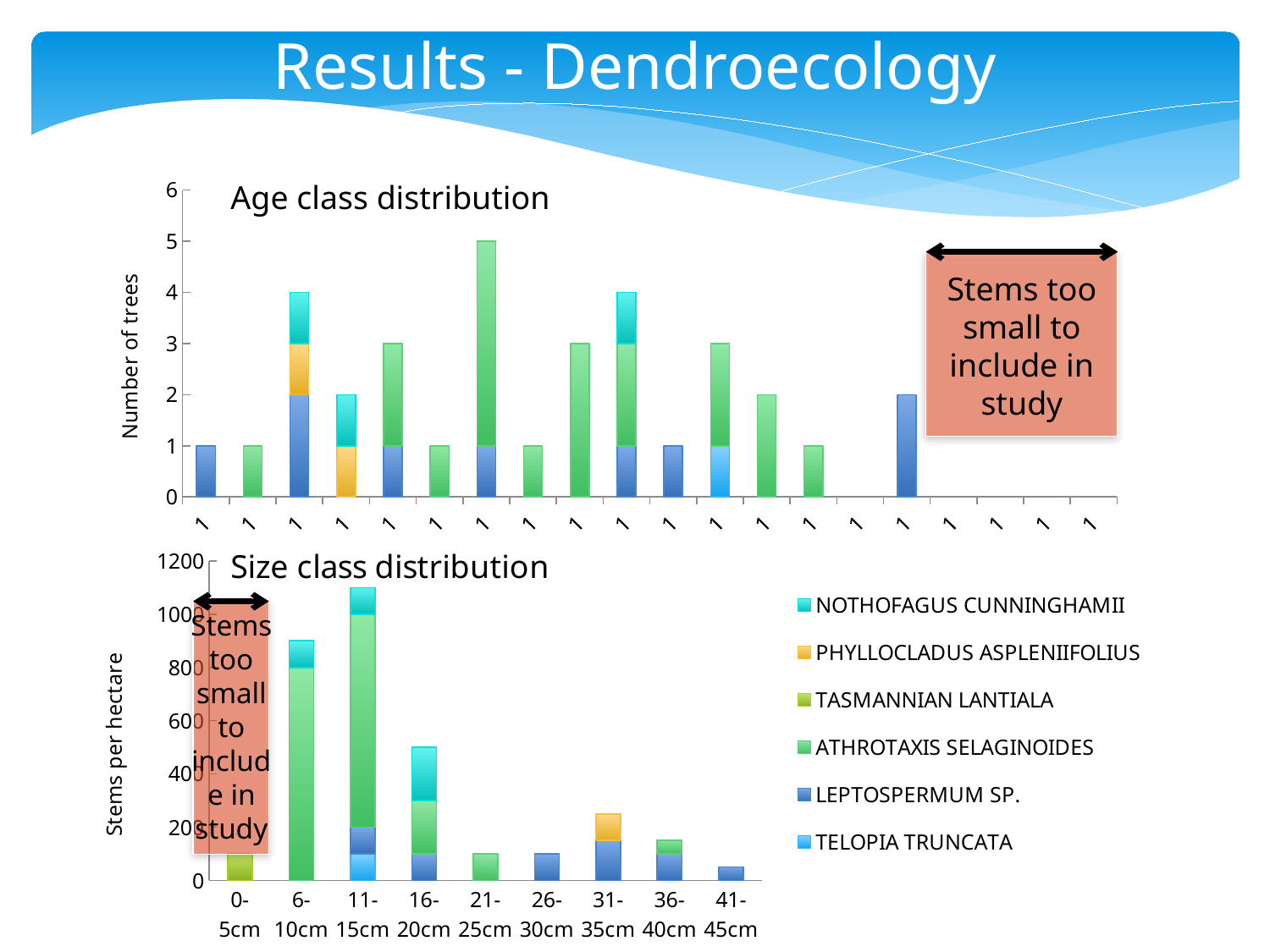
In the Size class distribution chart, is the total for 16-20cm greater or less than 600? less In the Age class distribution chart, what is the highest number of trees reached by any bar? 5 How many size classes are shown on the x axis of the Size class distribution chart? 9 How many series does the legend list? 6 In the Size class distribution chart, is the total for 6-10cm greater or less than 800? greater In the Size class distribution chart, which has the larger total, 6-10cm or 16-20cm? 6-10cm In the Size class distribution chart, is the total for 11-15cm greater or less than 1000? greater In the Size class distribution chart, which size class has the tallest bar? 11-15cm What type of chart is the Size class distribution chart? Stacked bar chart In the Size class distribution chart, do the bar totals generally rise or fall from 11-15cm to 41-45cm? Fall